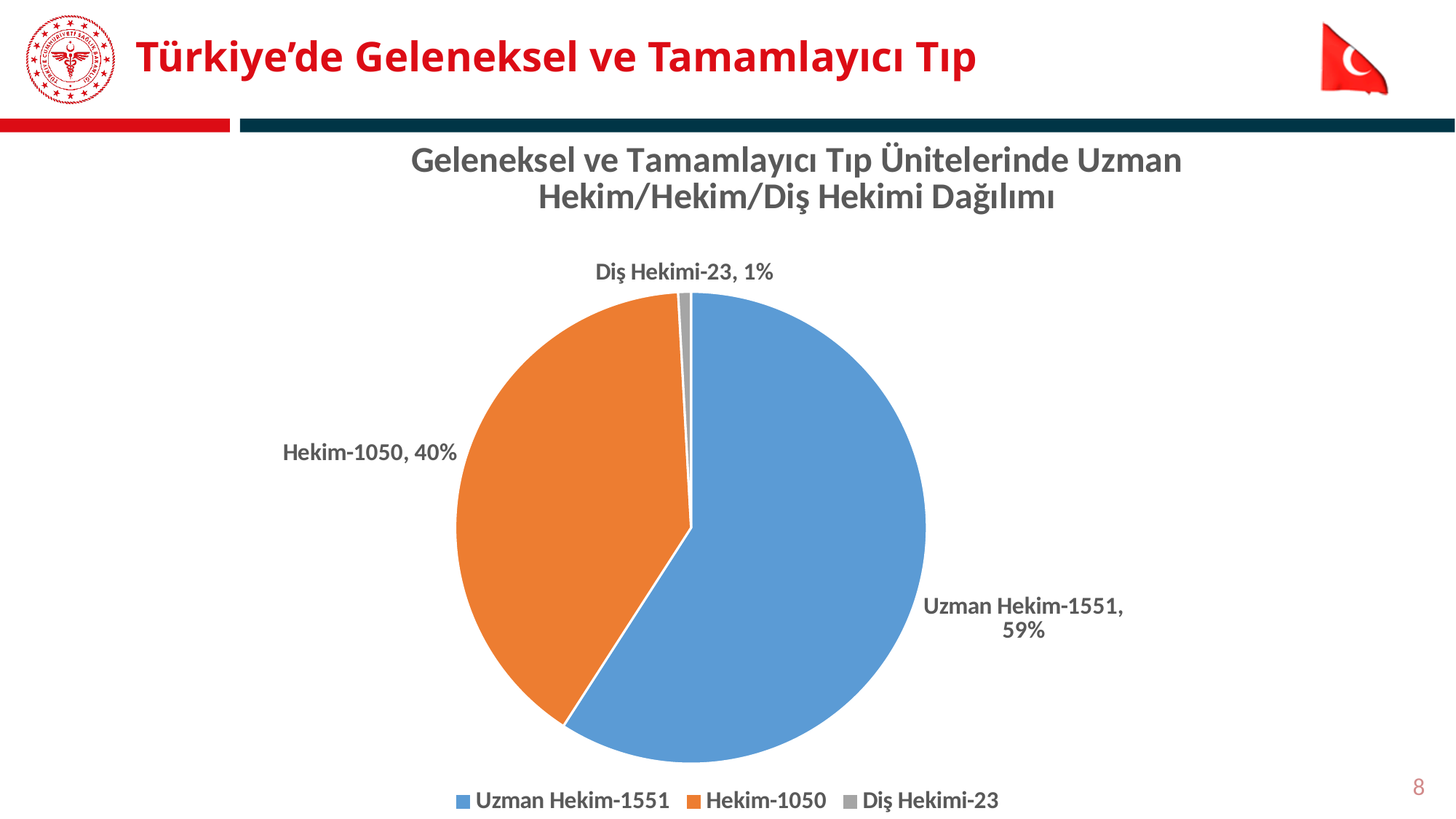
How many slices does the pie chart have? 3 Which category has the smallest slice? Diş Hekimi What is the difference between the Uzman Hekim count and the Hekim count? 501 Which category has the largest slice? Uzman Hekim What kind of chart is shown on the slide? pie chart How many entries does the legend list? 3 What percentage share does the Diş Hekimi slice have? 1% What percentage share does the Hekim slice have? 40% What percentage share does the Uzman Hekim slice have? 59% What is the count shown for Diş Hekimi? 23 What is the count shown for Uzman Hekim? 1551 What is the chart's title? Geleneksel ve Tamamlayıcı Tıp Ünitelerinde Uzman Hekim/Hekim/Diş Hekimi Dağılımı